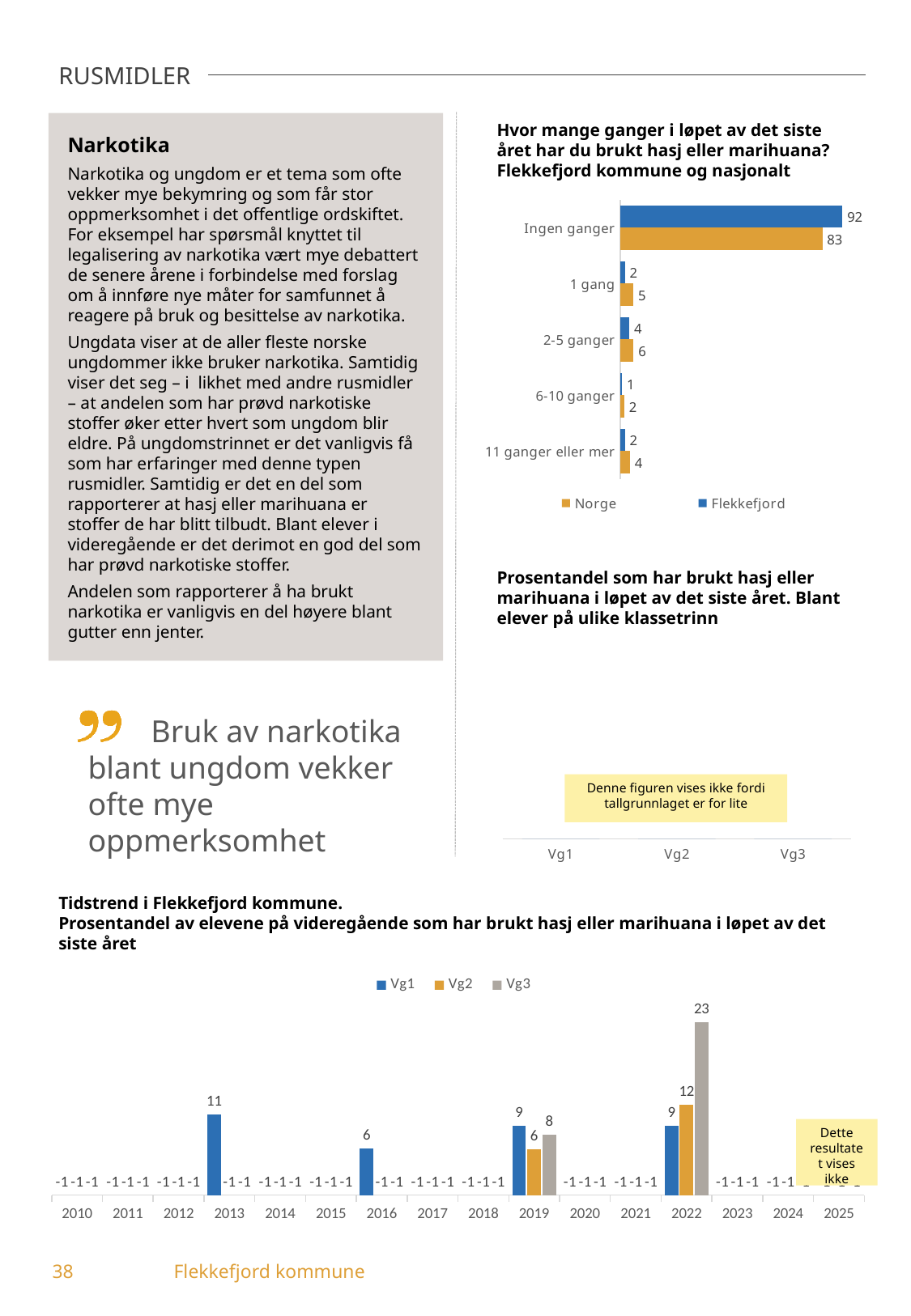
In the chart 'Hvor mange ganger i løpet av det siste året har du brukt hasj eller marihuana?', how many series does the legend list? 2 In the chart 'Hvor mange ganger i løpet av det siste året har du brukt hasj eller marihuana?', how many categories are shown? 5 In the chart 'Hvor mange ganger i løpet av det siste året har du brukt hasj eller marihuana?', which is larger for '2-5 ganger': Norge or Flekkefjord? Norge In the chart 'Hvor mange ganger i løpet av det siste året har du brukt hasj eller marihuana?', what is the value for Norge for '1 gang'? 5 In the chart 'Tidstrend i Flekkefjord kommune', what is the difference between Vg2 in 2022 and Vg2 in 2019? 6 In the chart 'Tidstrend i Flekkefjord kommune', what is the value for Vg3 in 2022? 23 In the chart 'Hvor mange ganger i løpet av det siste året har du brukt hasj eller marihuana?', what is the value for Flekkefjord for 'Ingen ganger'? 92 What kind of chart is 'Hvor mange ganger i løpet av det siste året har du brukt hasj eller marihuana?'? Bar chart In the chart 'Hvor mange ganger i løpet av det siste året har du brukt hasj eller marihuana?', what is the difference between Flekkefjord and Norge for 'Ingen ganger'? 9 In the chart 'Tidstrend i Flekkefjord kommune', which series has the highest value in 2022? Vg3 In the chart 'Hvor mange ganger i løpet av det siste året har du brukt hasj eller marihuana?', what is the value for Norge for 'Ingen ganger'? 83 In the chart 'Tidstrend i Flekkefjord kommune', what is the value for Vg1 in 2013? 11